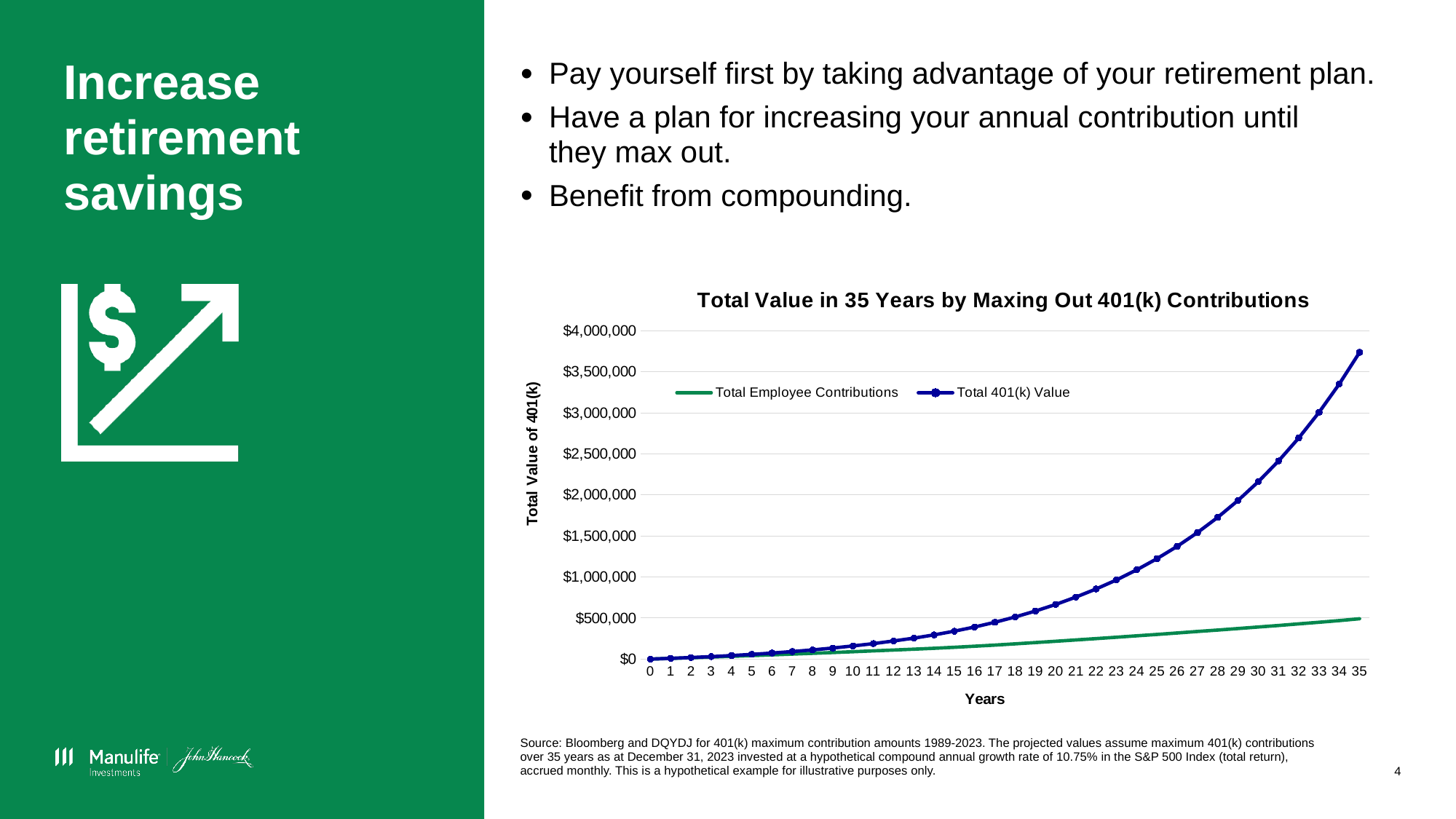
What is the label on the x axis of the chart? Years Is the Total 401(k) Value at year 25 greater or less than $1,000,000? greater Is the Total Employee Contributions value at year 35 greater or less than $1,000,000? less Is the Total 401(k) Value at year 35 greater or less than $3,500,000? greater What is the title of the chart? Total Value in 35 Years by Maxing Out 401(k) Contributions How many series does the chart's legend list? 2 What kind of chart is shown on the slide? Line chart Which series is drawn in green? Total Employee Contributions How many yearly points are plotted along the x axis, from year 0 to year 35? 36 In which year does the Total 401(k) Value series reach its highest point? 35 Does the Total 401(k) Value series rise or fall as the years increase? Rise At year 35, which series has the larger value: Total Employee Contributions or Total 401(k) Value? Total 401(k) Value